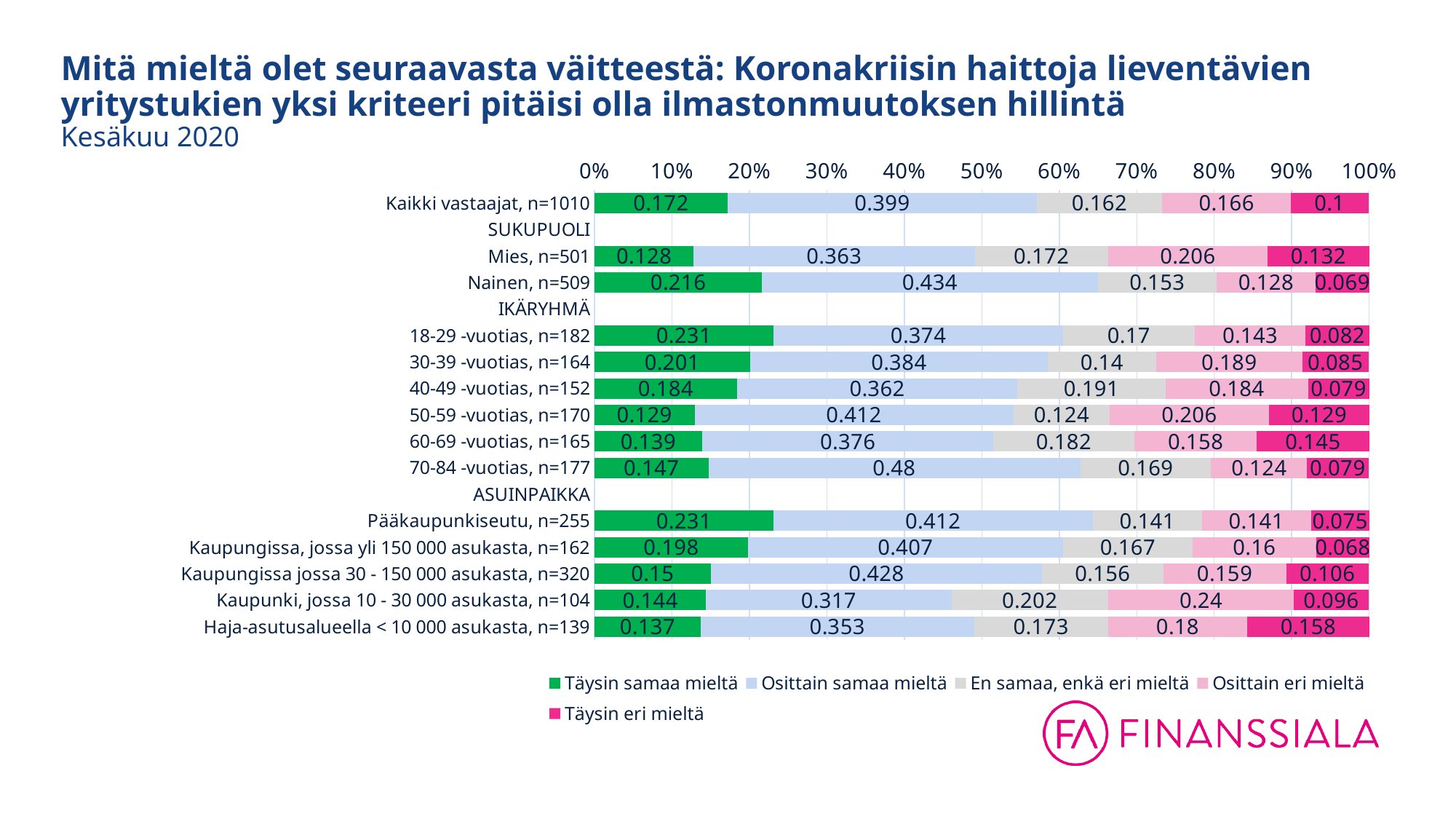
What is the value of 'Osittain eri mieltä' for 'Kaupunki, jossa 10 - 30 000 asukasta, n=104'? 0.24 What is the value of 'Täysin eri mieltä' for 'Mies, n=501'? 0.132 Which category has the highest value for 'Täysin eri mieltä'? Haja-asutusalueella < 10 000 asukasta, n=139 Which category has the lowest value for 'Täysin eri mieltä'? Kaupungissa, jossa yli 150 000 asukasta, n=162 Which has the larger 'Täysin eri mieltä' value, 'Mies, n=501' or 'Nainen, n=509'? Mies, n=501 What is the value of 'Osittain samaa mieltä' for '70-84 -vuotias, n=177'? 0.48 How many age groups (IKÄRYHMÄ) are shown in the chart? 6 What is the difference between the 'Täysin samaa mieltä' values for 'Nainen, n=509' and 'Mies, n=501'? 0.088 How many series does the legend list? 5 Which category has the highest value for 'Osittain samaa mieltä'? 70-84 -vuotias, n=177 What kind of chart is shown on the slide? Stacked bar chart What is the value of 'Täysin samaa mieltä' for 'Kaikki vastaajat, n=1010'? 0.172